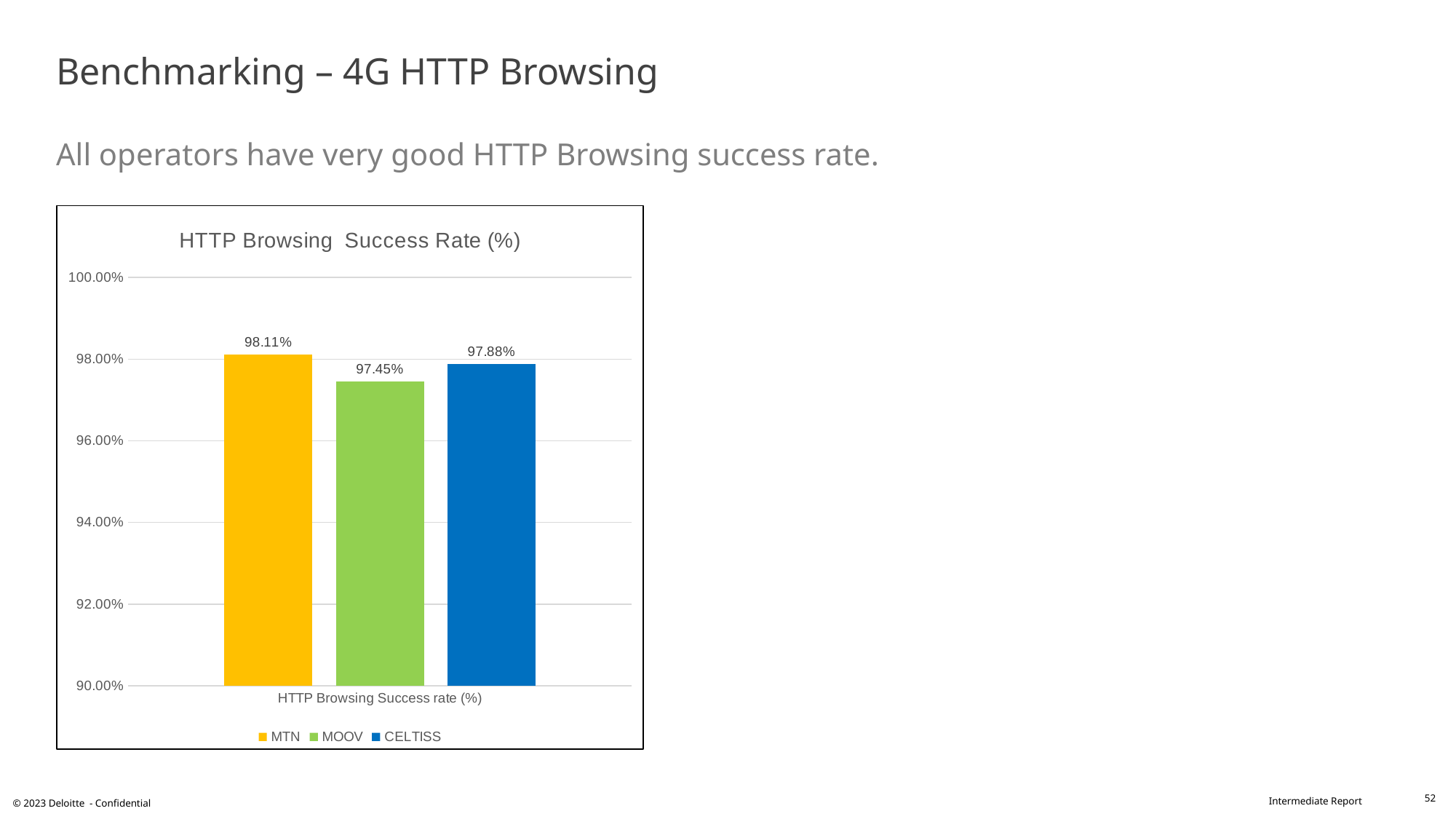
What is the difference between CELTISS's and MOOV's HTTP Browsing success rates? 0.43% Which operator has the lowest HTTP Browsing success rate? MOOV What is the HTTP Browsing success rate for CELTISS? 97.88% What is the title of the chart? HTTP Browsing Success Rate (%) Which operator has the highest HTTP Browsing success rate? MTN Is the HTTP Browsing success rate for MOOV greater or less than 98.00%? less How many series does the legend list? 3 What is the HTTP Browsing success rate for MOOV? 97.45% What kind of chart is shown on the slide? Bar chart Which has a higher HTTP Browsing success rate, CELTISS or MOOV? CELTISS What is the HTTP Browsing success rate for MTN? 98.11% What is the difference between MTN's and MOOV's HTTP Browsing success rates? 0.66%